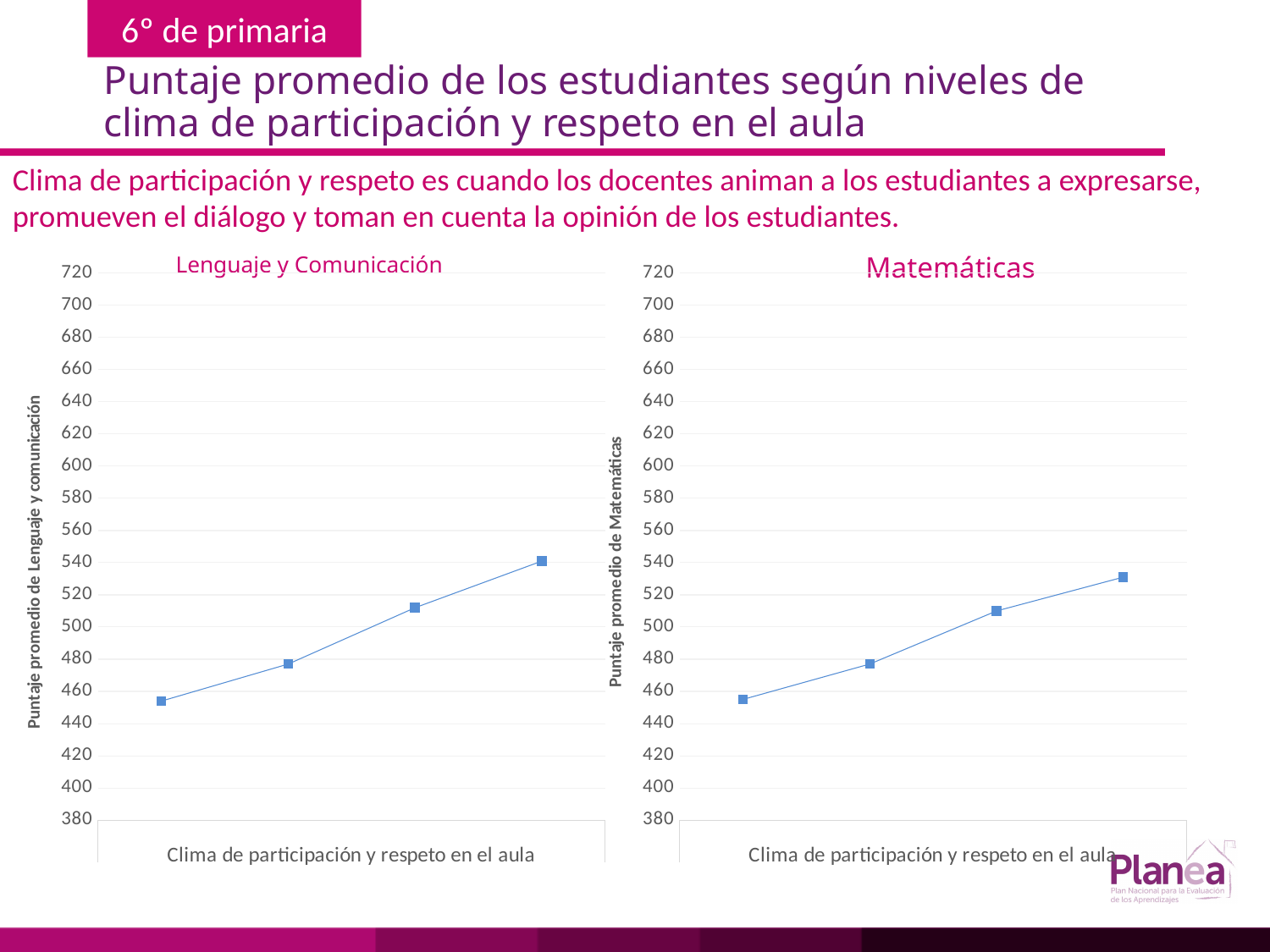
How many data points are plotted on the Matemáticas chart? 4 On the Lenguaje y Comunicación chart, do the values rise or fall from left to right along the x axis? rise What is the x-axis title of the Lenguaje y Comunicación chart? Clima de participación y respeto en el aula What kind of chart is the Matemáticas chart? line chart On the Lenguaje y Comunicación chart, is the value of the rightmost point greater or less than 520? greater On the Lenguaje y Comunicación chart, is the value of the leftmost point greater or less than 480? less On the Matemáticas chart, is the value of the rightmost point greater or less than 520? greater On the Matemáticas chart, which point has the highest value, the leftmost or the rightmost? the rightmost On the Matemáticas chart, do the values rise or fall from left to right along the x axis? rise How many data points are plotted on the Lenguaje y Comunicación chart? 4 What kind of chart is the Lenguaje y Comunicación chart? line chart